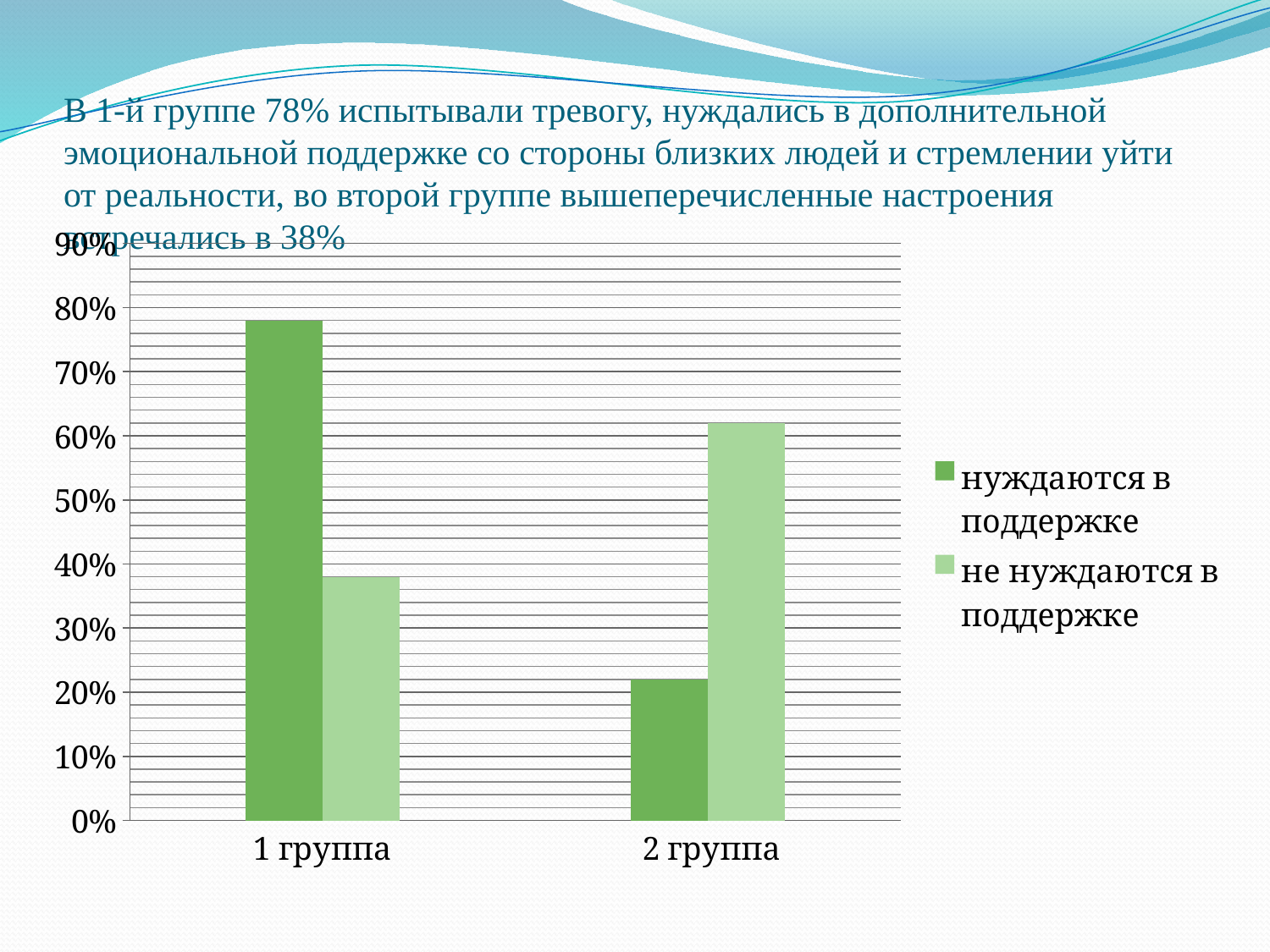
What kind of chart is shown on the slide? bar chart Which group has the higher value for 'нуждаются в поддержке'? 1 группа How many series does the chart legend list? 2 Is the value for 'нуждаются в поддержке' in '2 группа' greater or less than 30%? less Which group has the higher value for 'не нуждаются в поддержке'? 2 группа Is the value for 'нуждаются в поддержке' in '1 группа' greater or less than 70%? greater How many categories are shown on the x axis of the chart? 2 Which bar in the chart is the shortest? нуждаются в поддержке, 2 группа Which series is shown in the lighter green colour in the legend? не нуждаются в поддержке Which bar in the chart is the tallest? нуждаются в поддержке, 1 группа Is the value for 'не нуждаются в поддержке' in '1 группа' greater or less than 40%? less